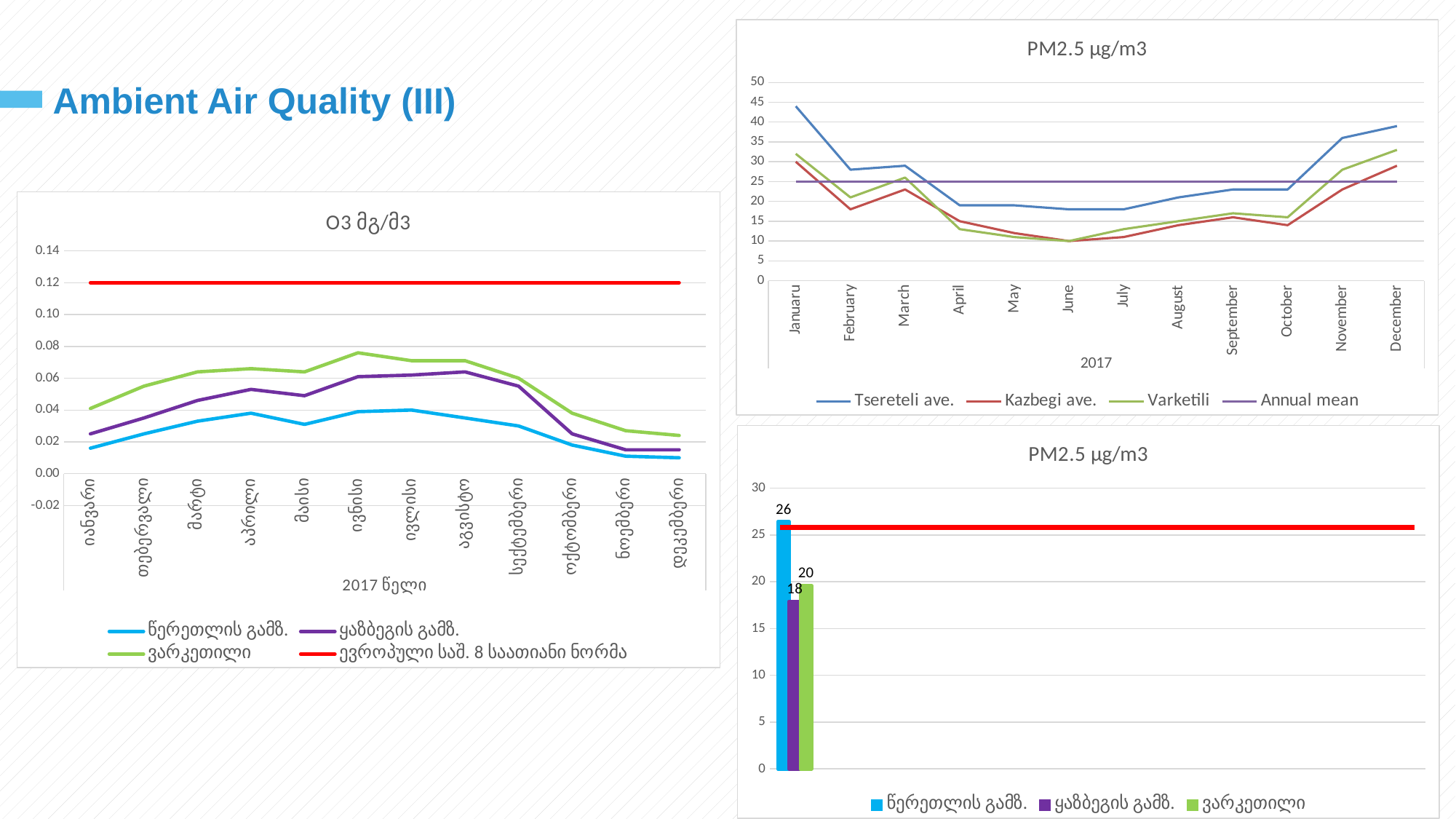
In the bottom-right PM2.5 µg/m3 bar chart, what is the value for ყაზბეგის გამზ.? 18 In the bottom-right PM2.5 µg/m3 bar chart, what is the difference between the values for წერეთლის გამზ. and ვარკეთილი? 6 In the top-right PM2.5 µg/m3 line chart, what is the value of the Annual mean line? 25 In the bottom-right PM2.5 µg/m3 bar chart, which series has the lowest value? ყაზბეგის გამზ. In the O3 მგ/მ3 chart, what is the value of the red ევროპული საშ. 8 საათიანი ნორმა line? 0.12 In the bottom-right PM2.5 µg/m3 bar chart, what is the value for წერეთლის გამზ.? 26 In the top-right PM2.5 µg/m3 line chart, in which month is Tsereteli ave. highest? Januaru In the top-right PM2.5 µg/m3 line chart, is the value for Tsereteli ave. in Januaru greater or less than 40? greater In the top-right PM2.5 µg/m3 line chart, which is larger in February: Tsereteli ave. or Kazbegi ave.? Tsereteli ave. What kind of chart is the bottom-right PM2.5 µg/m3 chart? bar chart How many series does the legend of the bottom-right PM2.5 µg/m3 bar chart list? 3 In the O3 მგ/მ3 chart, how many series does the legend list? 4